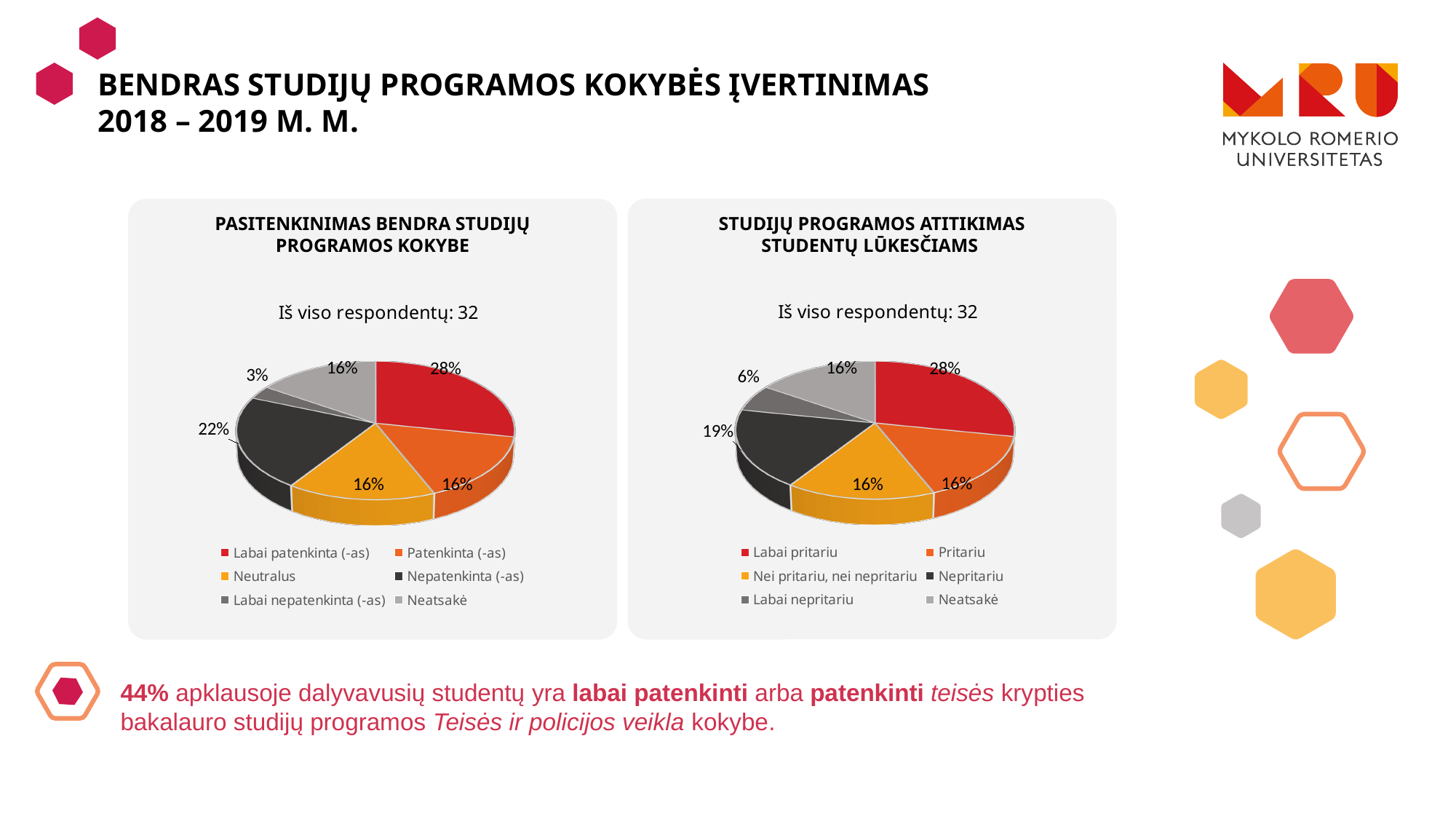
In the chart titled 'STUDIJŲ PROGRAMOS ATITIKIMAS STUDENTŲ LŪKESČIAMS', what percentage is shown for 'Nepritariu'? 19% In the chart titled 'STUDIJŲ PROGRAMOS ATITIKIMAS STUDENTŲ LŪKESČIAMS', what is the difference between 'Labai pritariu' and 'Nepritariu'? 9% In the chart titled 'STUDIJŲ PROGRAMOS ATITIKIMAS STUDENTŲ LŪKESČIAMS', which category has the largest share? Labai pritariu In the chart titled 'PASITENKINIMAS BENDRA STUDIJŲ PROGRAMOS KOKYBE', what is the difference between 'Labai patenkinta (-as)' and 'Labai nepatenkinta (-as)'? 25% In the chart titled 'STUDIJŲ PROGRAMOS ATITIKIMAS STUDENTŲ LŪKESČIAMS', what percentage is shown for 'Labai nepritariu'? 6% In the chart titled 'PASITENKINIMAS BENDRA STUDIJŲ PROGRAMOS KOKYBE', what percentage is shown for 'Labai patenkinta (-as)'? 28% In the chart titled 'PASITENKINIMAS BENDRA STUDIJŲ PROGRAMOS KOKYBE', which category has the smallest share? Labai nepatenkinta (-as) In the chart titled 'STUDIJŲ PROGRAMOS ATITIKIMAS STUDENTŲ LŪKESČIAMS', which is larger: 'Nepritariu' or 'Neatsakė'? Nepritariu In the chart titled 'PASITENKINIMAS BENDRA STUDIJŲ PROGRAMOS KOKYBE', what percentage is shown for 'Nepatenkinta (-as)'? 22% What kind of chart is the chart titled 'STUDIJŲ PROGRAMOS ATITIKIMAS STUDENTŲ LŪKESČIAMS'? Pie chart How many respondents are reported for the chart titled 'PASITENKINIMAS BENDRA STUDIJŲ PROGRAMOS KOKYBE'? 32 How many categories does the legend of the chart titled 'PASITENKINIMAS BENDRA STUDIJŲ PROGRAMOS KOKYBE' list? 6